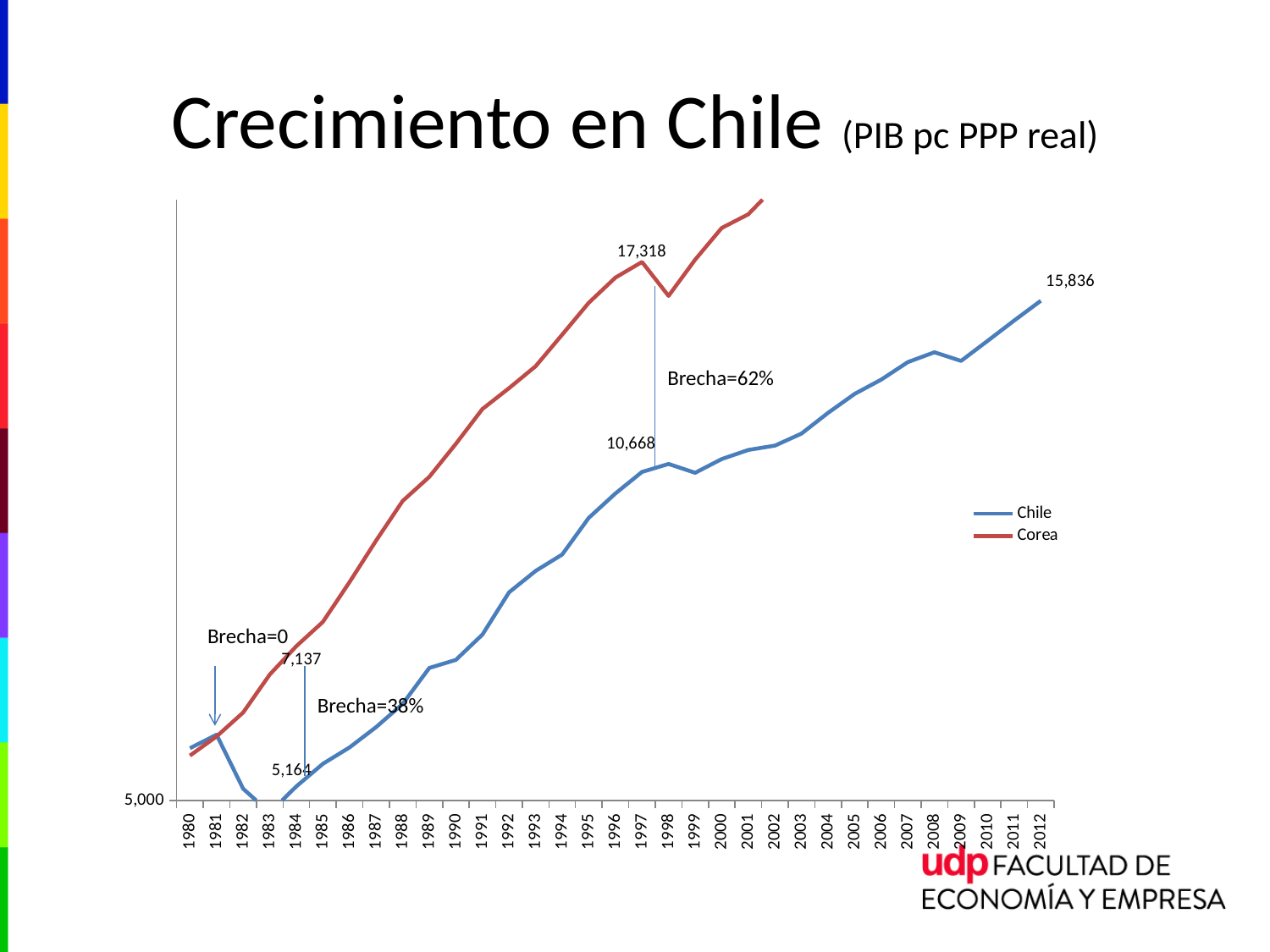
How many series does the legend list? 2 What is the value for Chile in 2012? 15,836 What gap (Brecha) is annotated on the chart for 1997? Brecha=62% What is the value for Corea in 1997? 17,318 What kind of chart is shown on the slide? line chart What is the value for Corea in 1984? 7,137 What is the difference between the Corea and Chile values in 1997? 6,650 Which series has the higher value in 1997, Chile or Corea? Corea What is the value for Chile in 1997? 10,668 What is the value for Chile in 1984? 5,164 How many years are shown on the x axis? 33 What is the difference between the Corea and Chile values in 1984? 1,973